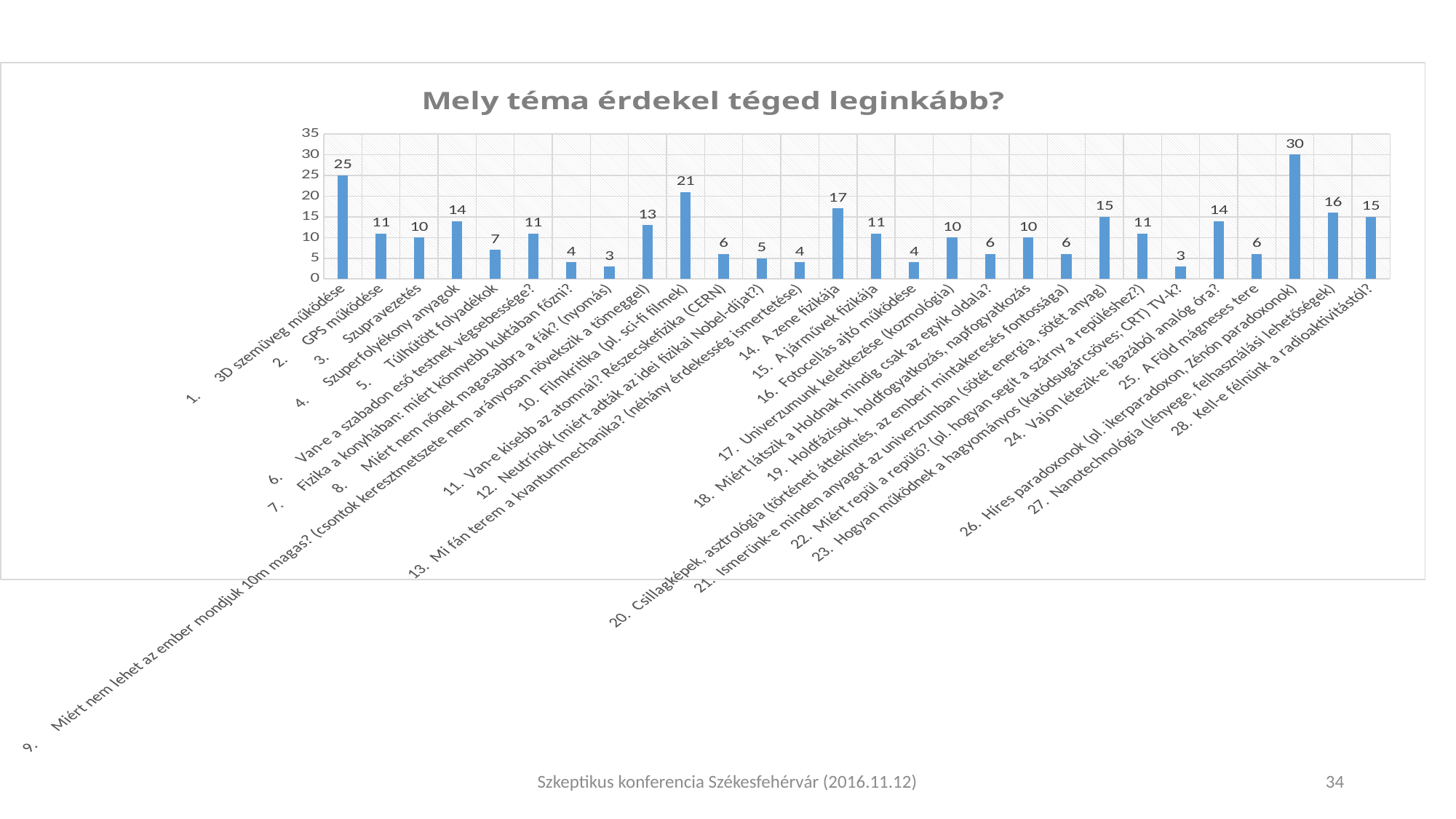
How many categories are shown in the chart? 28 Which category has the highest value? 26. Híres paradoxonok (pl. ikerparadoxon, Zénón paradoxonok) What is the title of the chart? Mely téma érdekel téged leginkább? What kind of chart is shown on the slide? bar chart What is the value for "14. A zene fizikája"? 17 What is the value for "27. Nanotechnológia (lényege, felhasználási lehetőségek)"? 16 What is the value for "1. 3D szemüveg működése"? 25 What is the difference between the values for "26. Híres paradoxonok" and "1. 3D szemüveg működése"? 5 What is the value for "23. Hogyan működnek a hagyományos (katódsugárcsöves; CRT) TV-k?"? 3 What is the value for "10. Filmkritika (pl. sci-fi filmek)"? 21 Which has a larger value, "4. Szuperfolyékony anyagok" or "5. Túlhűtött folyadékok"? 4. Szuperfolyékony anyagok Is the value for "21. Ismerünk-e minden anyagot az univerzumban" greater or less than 10? greater